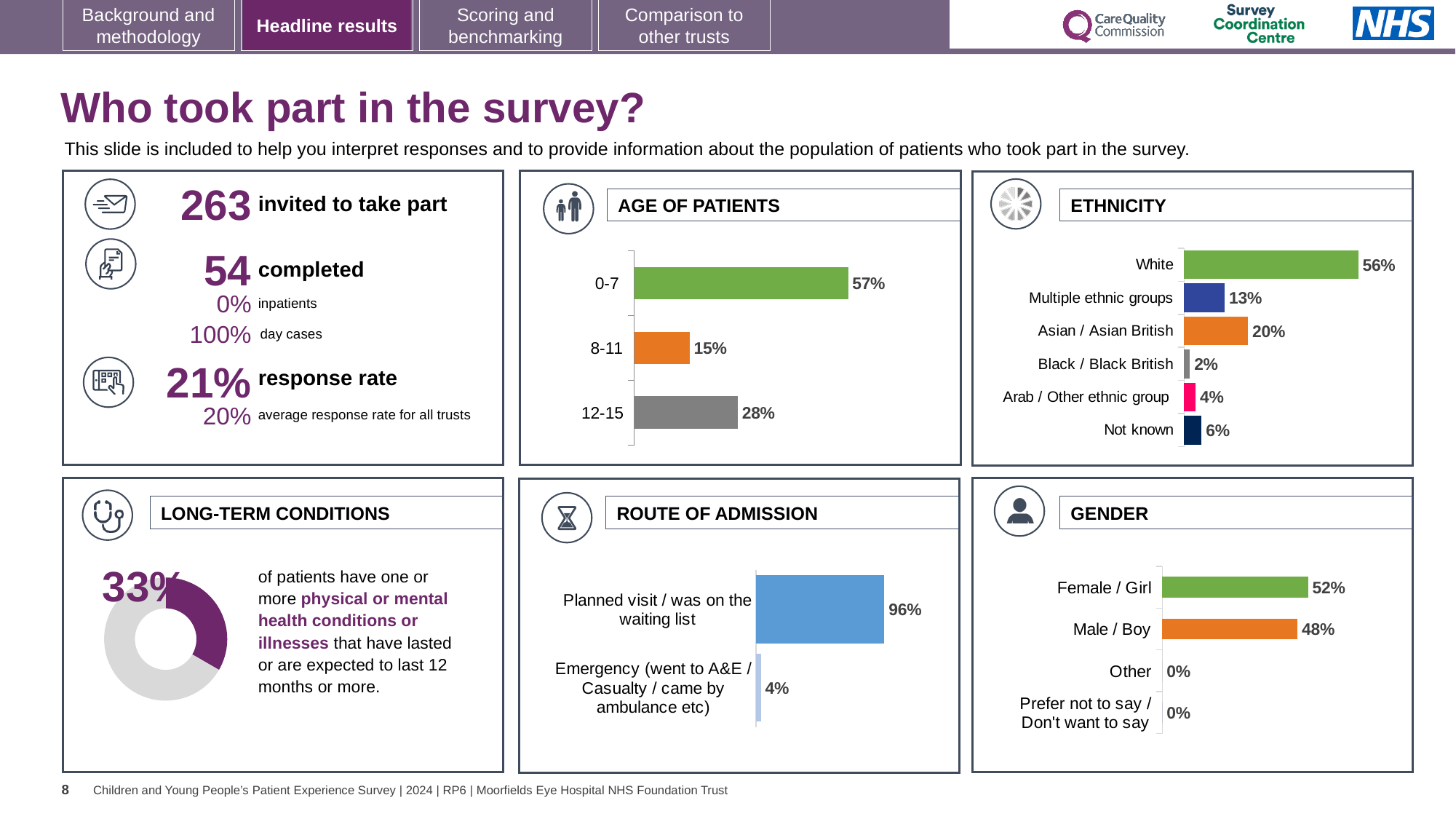
In the ETHNICITY chart, what percentage of patients were Asian / Asian British? 20% In the AGE OF PATIENTS chart, what is the difference between the 0-7 and 12-15 percentages? 29% In the ETHNICITY chart, how many ethnicity categories are shown? 6 What kind of chart is used in the LONG-TERM CONDITIONS panel? Doughnut chart In the ROUTE OF ADMISSION chart, what percentage of patients had a planned visit / were on the waiting list? 96% In the GENDER chart, what percentage of patients were Male / Boy? 48% In the AGE OF PATIENTS chart, which age group has the lowest percentage? 8-11 In the ETHNICITY chart, which category has the highest percentage? White In the ETHNICITY chart, which is larger: Multiple ethnic groups or Not known? Multiple ethnic groups In the ROUTE OF ADMISSION chart, what is the difference between the planned visit and emergency percentages? 92% In the AGE OF PATIENTS chart, what percentage of patients were aged 0-7? 57% In the GENDER chart, which category has the highest percentage? Female / Girl